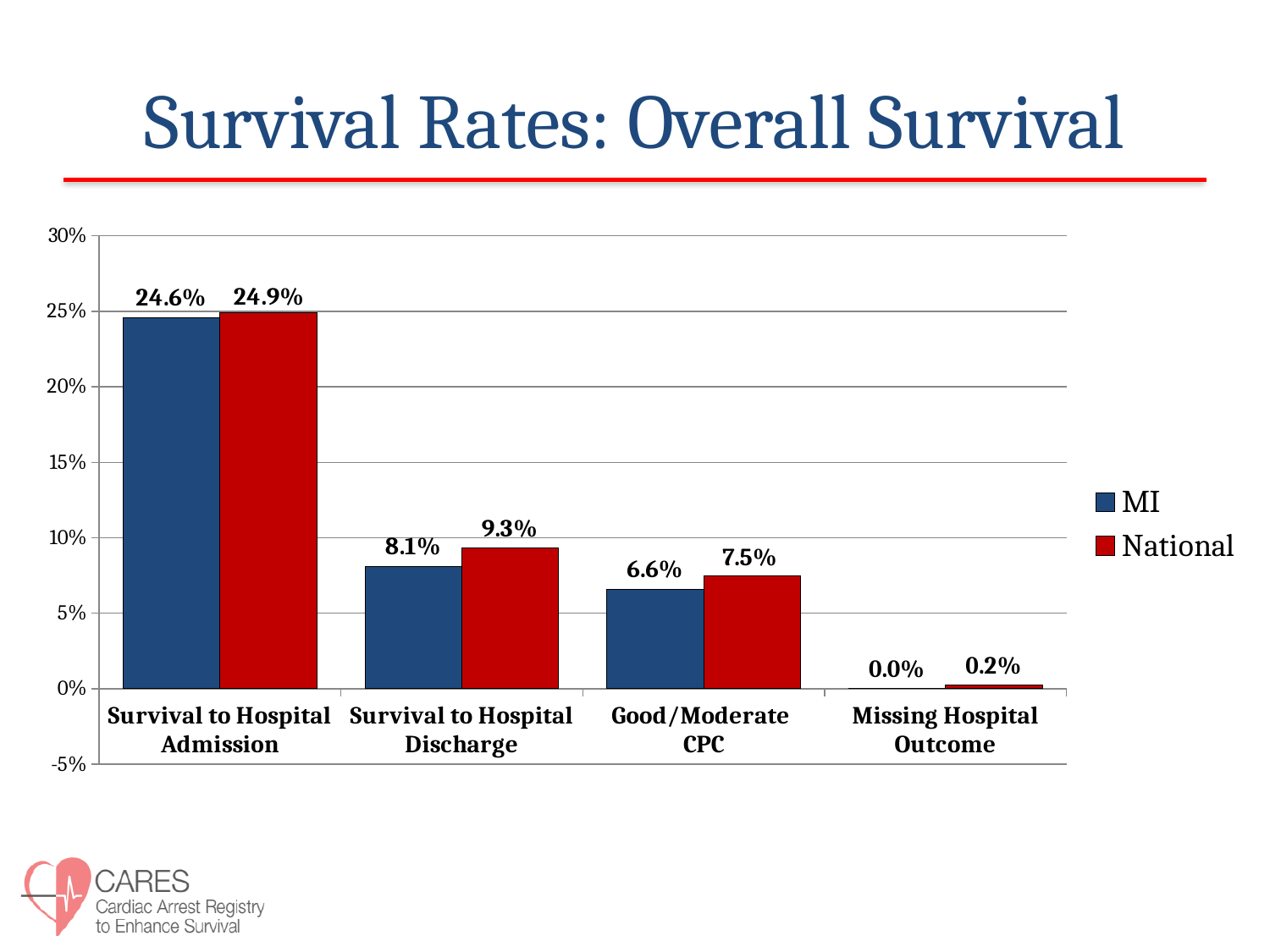
How many series does the legend list? 2 What is the National value for Good/Moderate CPC? 7.5% For Good/Moderate CPC, which is larger, the MI value or the National value? National What is the MI value for Survival to Hospital Admission? 24.6% Which category has the highest National value? Survival to Hospital Admission What is the National value for Survival to Hospital Discharge? 9.3% How many categories are shown on the x axis? 4 What is the difference between the National and MI values for Survival to Hospital Discharge? 1.2% What is the title of the slide? Survival Rates: Overall Survival What kind of chart is shown on the slide? Bar chart Which category has the lowest MI value? Missing Hospital Outcome What is the MI value for Missing Hospital Outcome? 0.0%